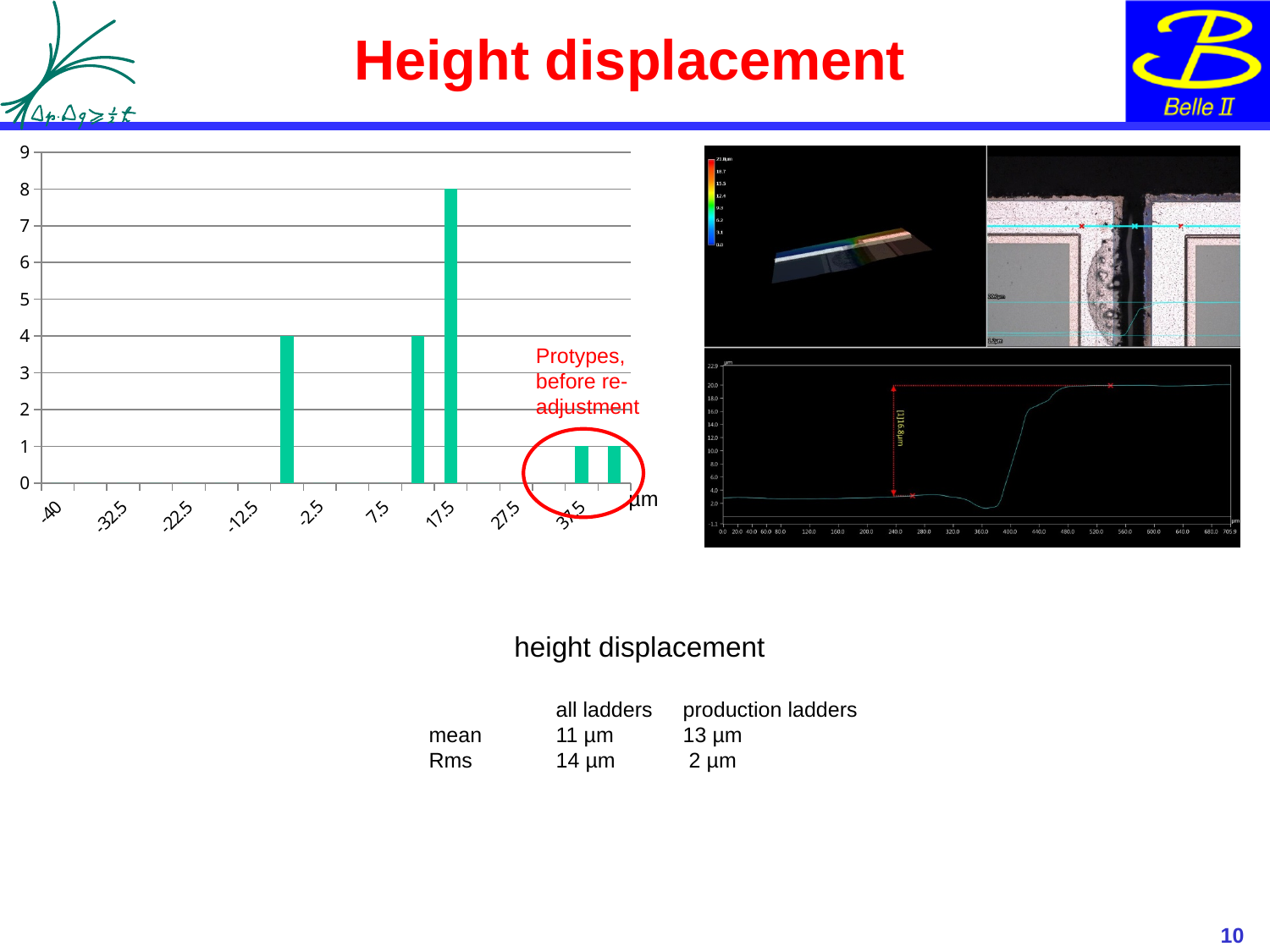
What type of chart is shown on the left of the slide? bar chart What is the height of the shortest bars in the chart? 1 What is the difference in height between the tallest bar and a bar of height 4? 4 What is the height of the tallest bar in the chart? 8 What annotation text is written next to the two circled bars on the right of the chart? Protypes, before re-adjustment How many bars are plotted in the chart? 5 What is the highest value shown on the y axis of the chart? 9 How many bars in the chart have a height of 1? 2 How many bars in the chart reach a height of 4? 2 Is the tallest bar in the chart greater or less than 5? greater